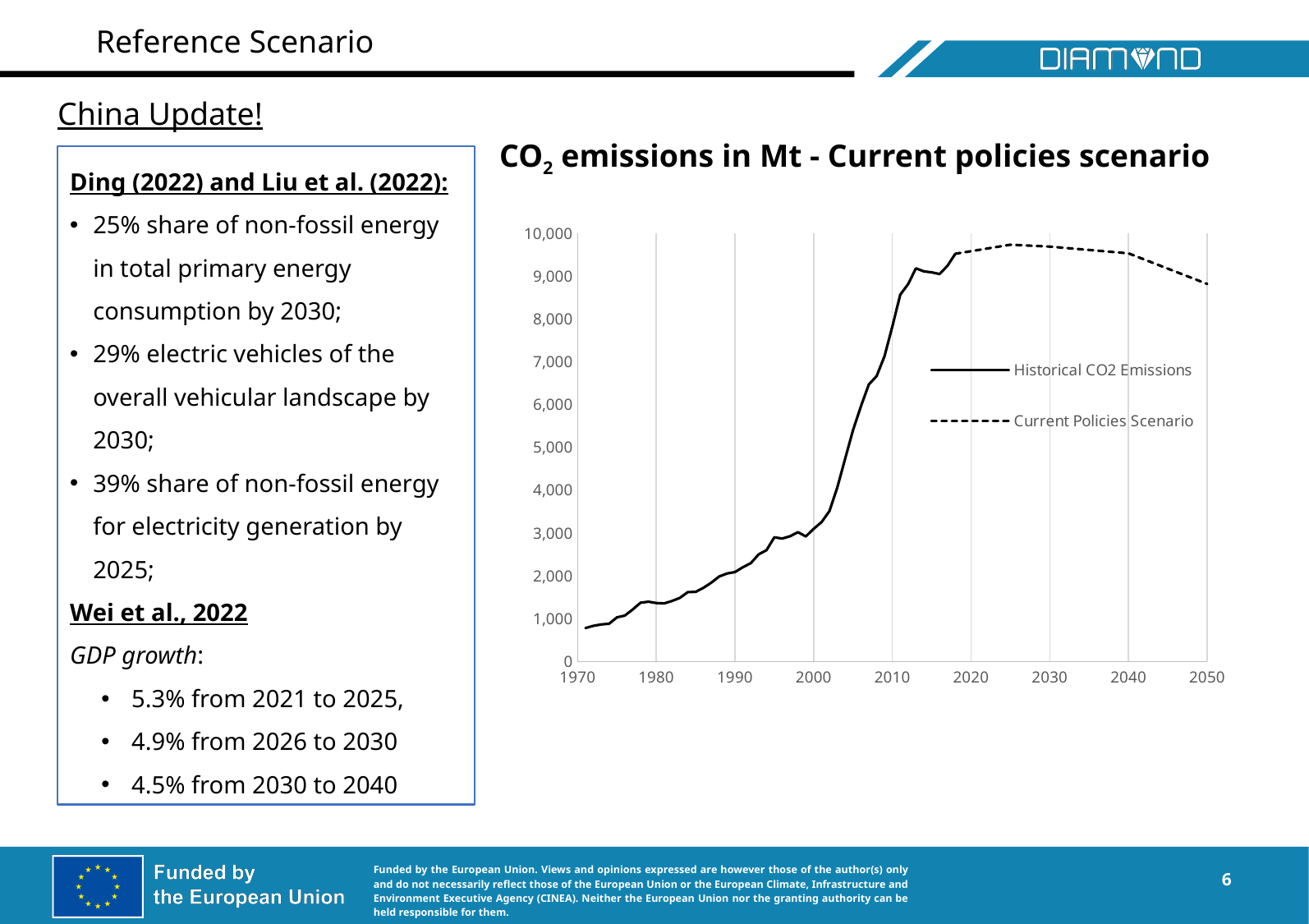
Is the Historical CO2 Emissions value in 1970 greater or less than 1,000? less How many year labels are shown on the x axis of the chart? 9 How many series does the chart legend list? 2 Is the Current Policies Scenario value in 2050 greater or less than 9,000? less Do the Historical CO2 Emissions rise or fall between 1970 and 2020? rise What is the title of the chart? CO2 emissions in Mt - Current policies scenario What are the two series named in the chart legend? Historical CO2 Emissions and Current Policies Scenario What kind of chart is shown on the slide? line chart Does the Current Policies Scenario line rise or fall between 2030 and 2050? fall Is the Historical CO2 Emissions value in 1980 greater or less than 1,000? greater